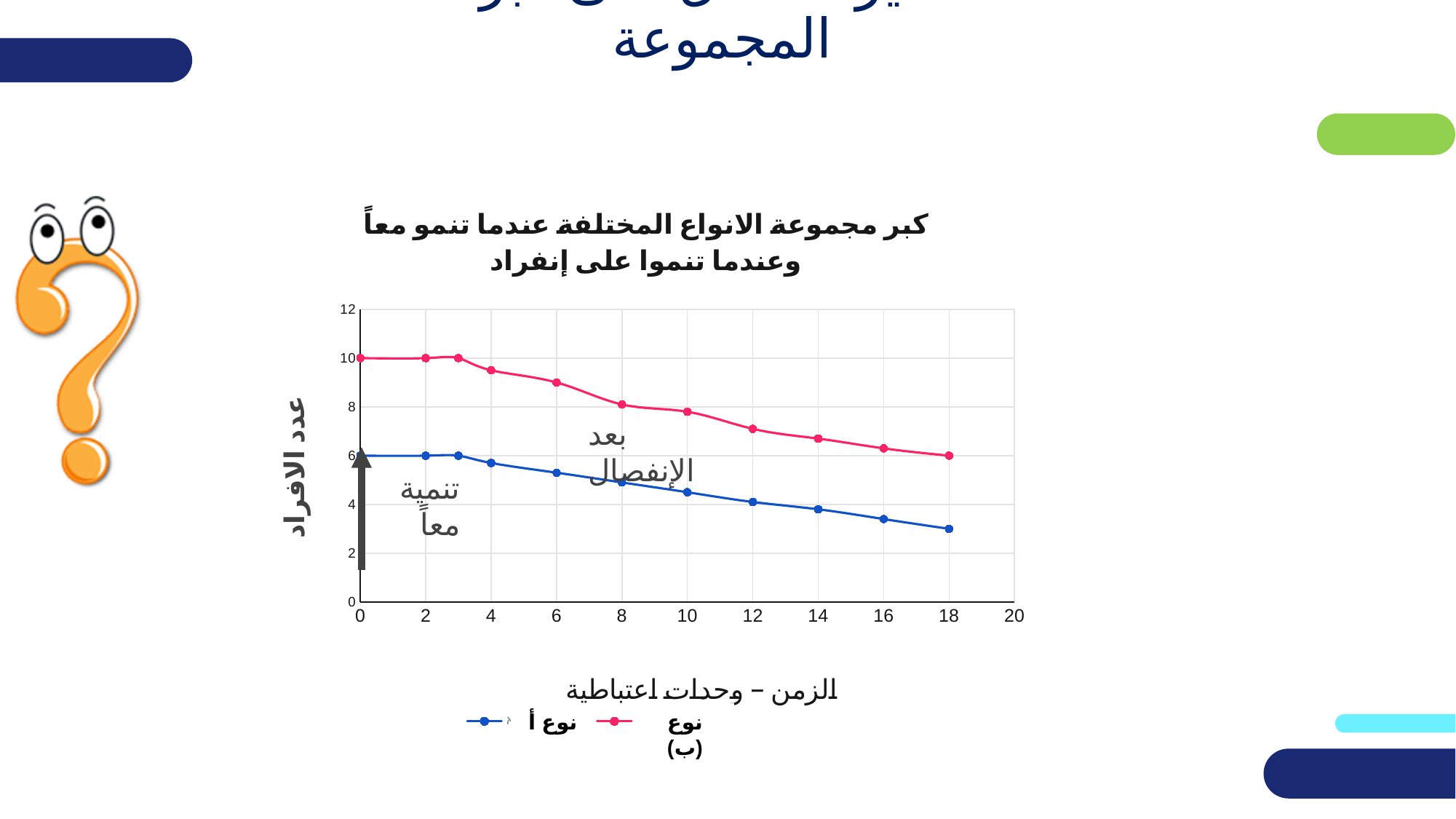
Do the values of نوع أ rise or fall as time increases along the x axis? fall What is the value of نوع (ب) at time 0? 10 Is the value for نوع أ at time 18 greater or less than 4? less Is the value for نوع (ب) at time 10 greater or less than 8? less What is the value of نوع (ب) at time 18? 6 Is the value for نوع (ب) at time 6 greater or less than 8? greater How many series does the legend list? 2 What is the value of نوع أ at time 0? 6 What is the difference between نوع (ب) and نوع أ at time 0? 4 Which series has the larger value at time 10, نوع أ or نوع (ب)? نوع (ب) What is the label of the y axis? عدد الافراد What kind of chart is shown on the slide? line chart